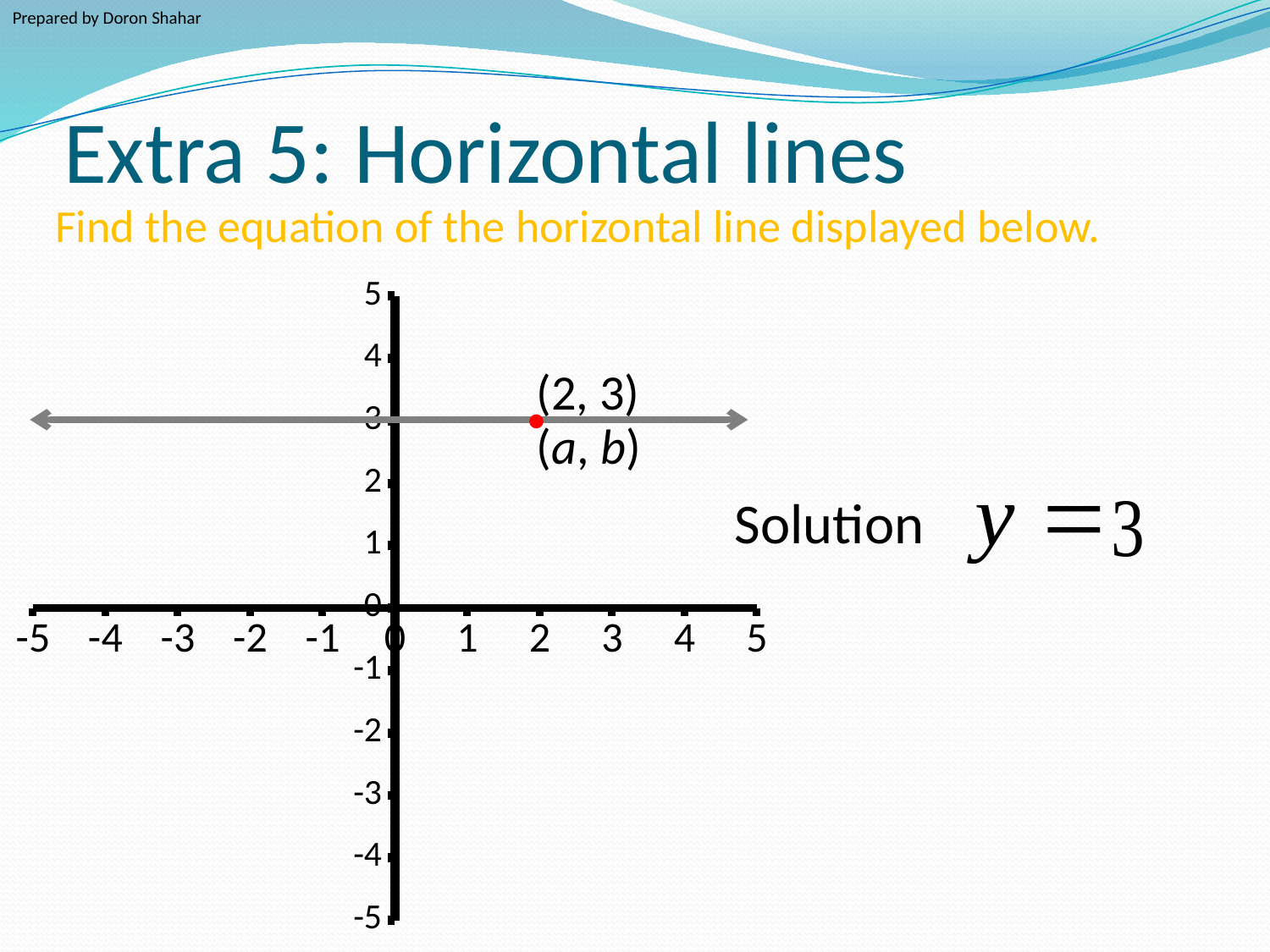
What are the coordinates of the red point marked on the graph? (2, 3) What colour is the point marked on the line? red Is the y-value of the horizontal line greater or less than 4? less What is the equation of the horizontal line shown on the graph? y = 3 At what y-value does the horizontal line cross the y-axis? 3 What is the x-coordinate of the red point on the graph? 2 What is the y-coordinate of the red point on the graph? 3 What range of values does the x-axis cover? -5 to 5 How many points are marked with a dot on the graph? 1 Is the horizontal line above or below the x-axis? above Is the y-value of the horizontal line greater or less than 2? greater Does the plotted line rise, fall, or stay constant as x increases? stays constant